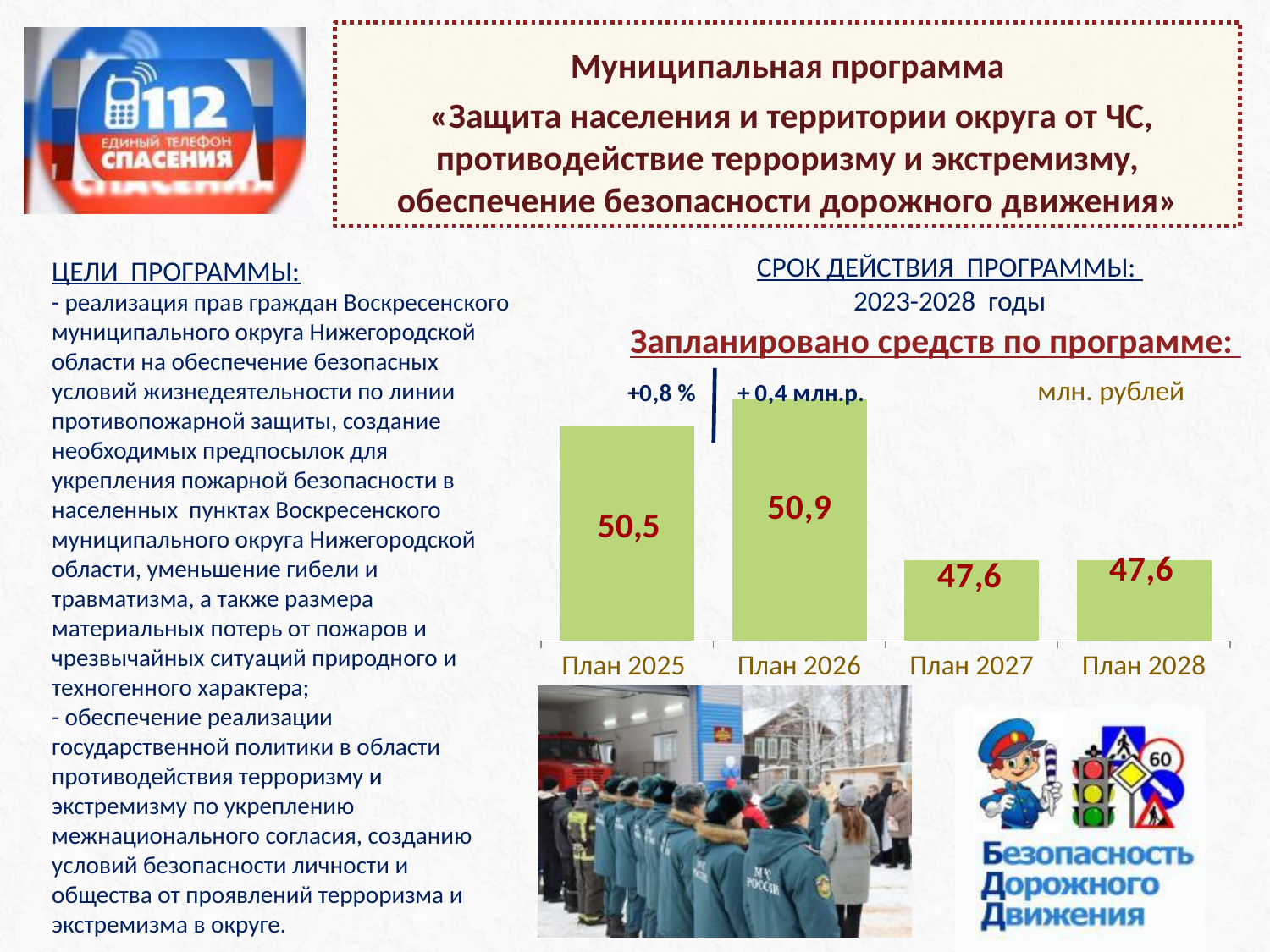
What value is shown for План 2027? 47,6 Do the values rise or fall from План 2026 to План 2027? fall What is the difference between the values for План 2026 and План 2025? 0,4 Which category has the highest value? План 2026 What unit is indicated for the chart values? млн. рублей What value is shown for План 2025? 50,5 How many categories are shown on the chart? 4 What kind of chart is shown on the slide? bar chart What is the difference between the values for План 2026 and План 2028? 3,3 What is the title of the chart? Запланировано средств по программе: What value is shown for План 2026? 50,9 Which is larger, the value for План 2025 or the value for План 2027? План 2025